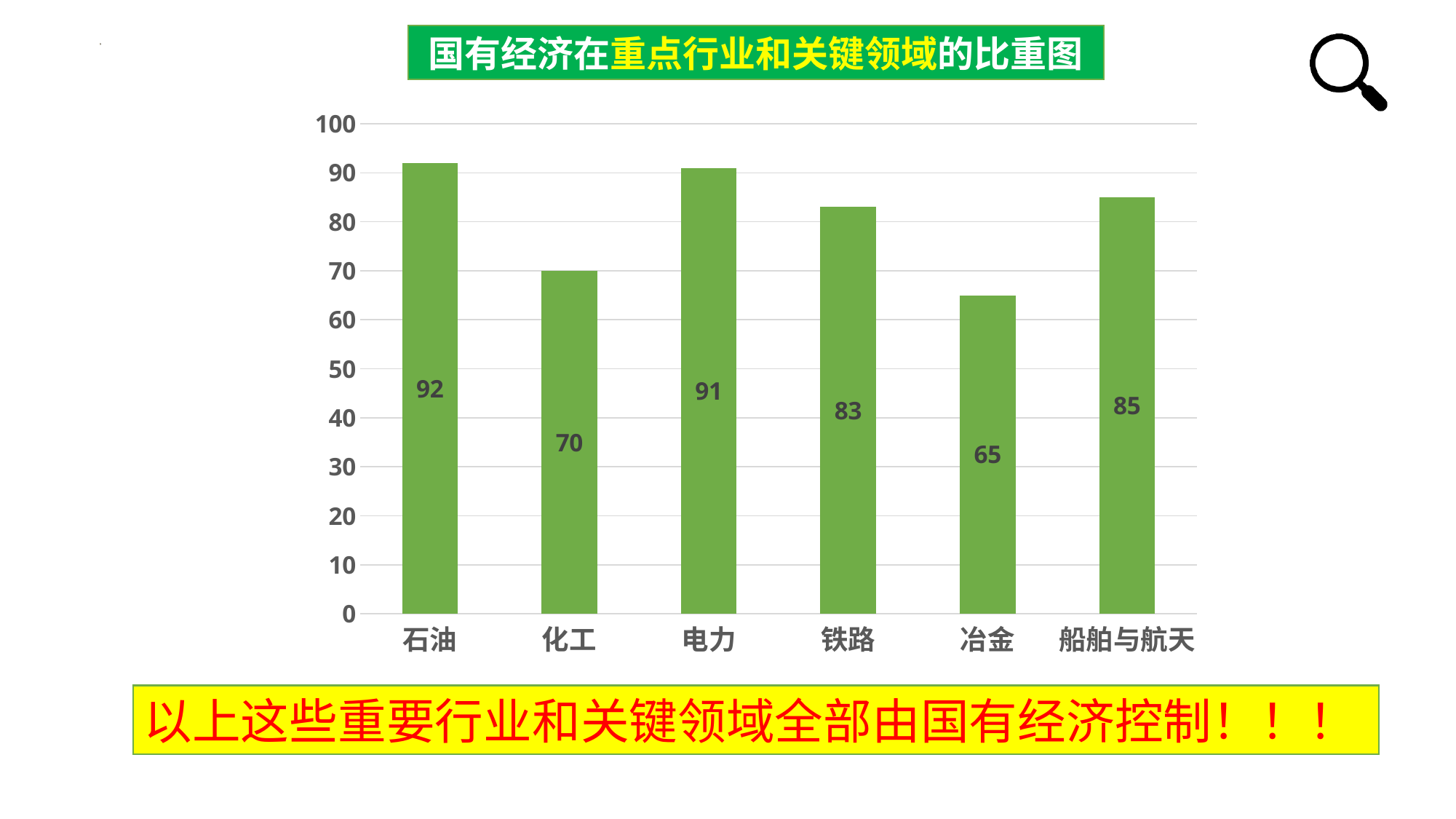
What is the title of the chart? 国有经济在重点行业和关键领域的比重图 Which category has the highest value? 石油 What kind of chart is shown on the slide? bar chart What is the value for 石油? 92 What is the difference between the values for 石油 and 冶金? 27 What is the value for 化工? 70 Is the value for 冶金 greater or less than 70? less What is the difference between the values for 铁路 and 化工? 13 What is the value for 船舶与航天? 85 How many categories are shown on the x axis? 6 Which category has the lowest value? 冶金 Which is larger, the value for 电力 or the value for 铁路? 电力